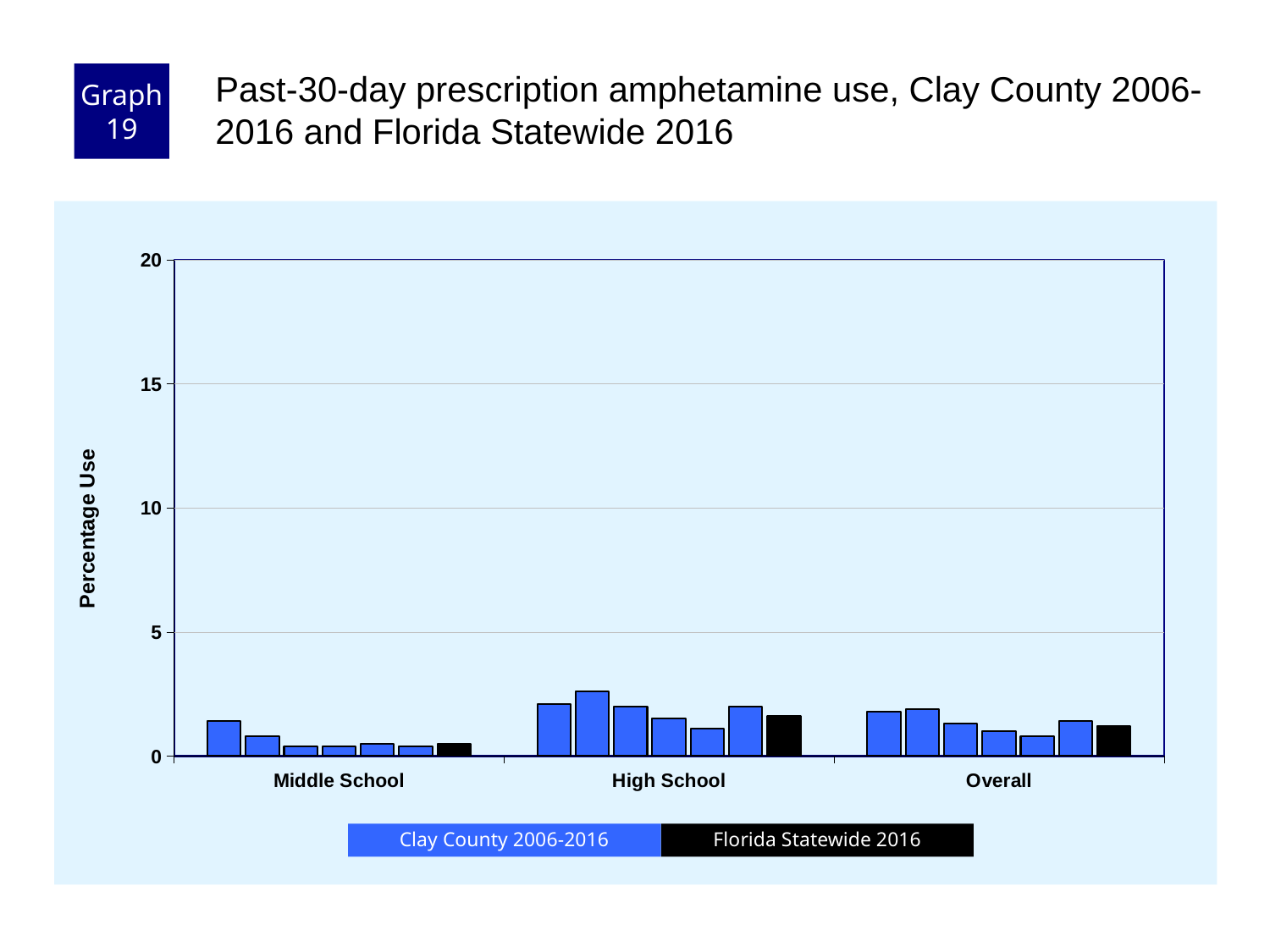
Which category has the lowest Florida Statewide 2016 value? Middle School What is the label of the y axis? Percentage Use Is the tallest Clay County 2006-2016 bar for High School greater or less than 5? less Which category contains the tallest bar in the chart? High School Is the Florida Statewide 2016 value for High School greater or less than 5? less How many categories are shown on the x axis of the chart? 3 What kind of chart is shown on the slide? bar chart Is the Florida Statewide 2016 value larger for Overall or for Middle School? Overall Is the Florida Statewide 2016 value for Overall greater or less than 10? less Which colour represents Florida Statewide 2016 in the chart? black How many series does the chart legend list? 2 Is the Florida Statewide 2016 value larger for High School or for Middle School? High School